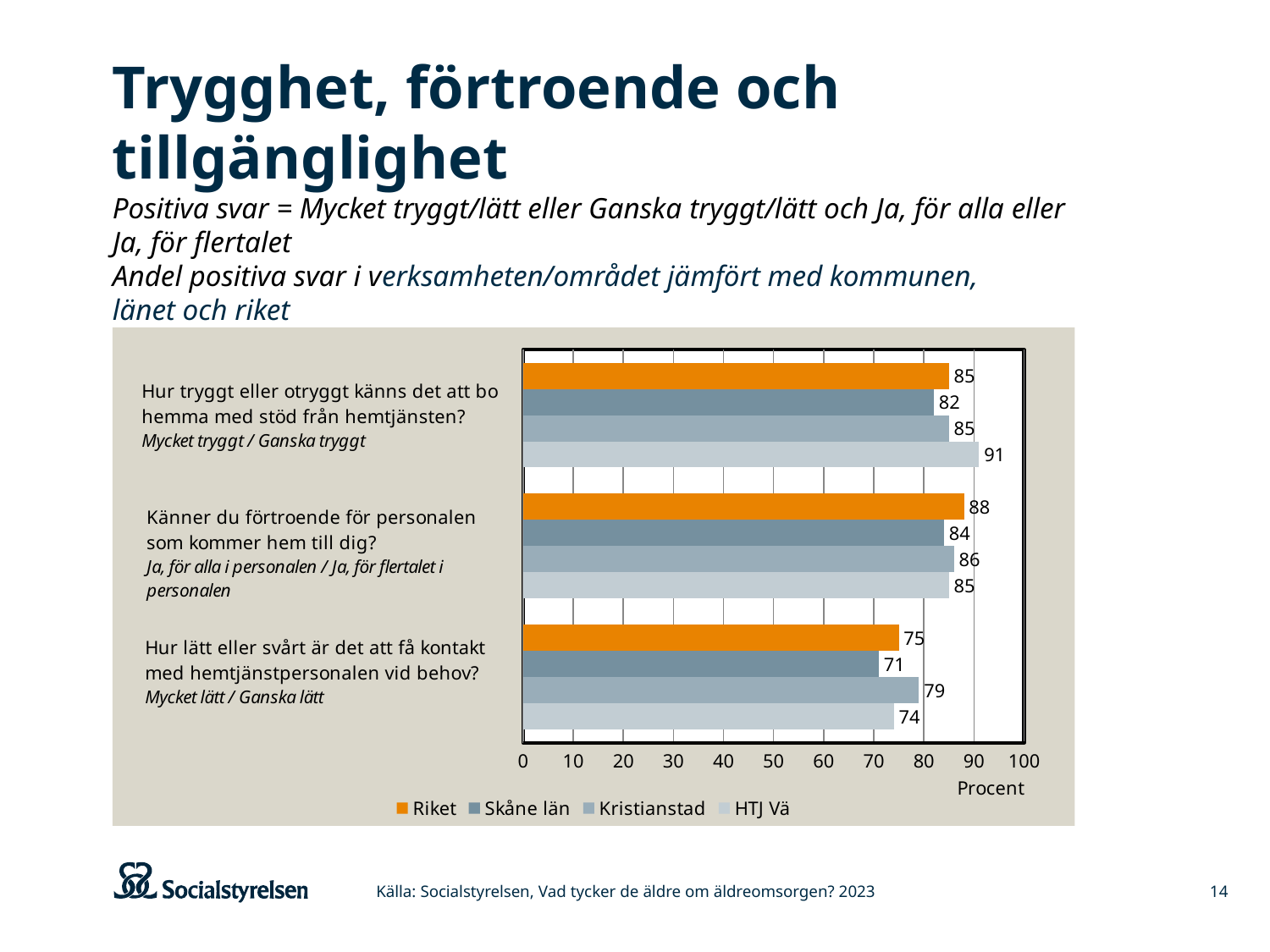
Which series has the lowest value on the question "Hur lätt eller svårt är det att få kontakt med hemtjänstpersonalen vid behov?"? Skåne län What is the value for Skåne län on the question "Hur lätt eller svårt är det att få kontakt med hemtjänstpersonalen vid behov?"? 71 Is the value for Riket on the question "Hur lätt eller svårt är det att få kontakt med hemtjänstpersonalen vid behov?" greater or less than 80? less What is the value for HTJ Vä on the question "Hur tryggt eller otryggt känns det att bo hemma med stöd från hemtjänsten?"? 91 On the question "Känner du förtroende för personalen som kommer hem till dig?", which is larger: the value for Kristianstad or the value for Skåne län? Kristianstad What is the difference between the Kristianstad value and the HTJ Vä value on the question "Hur lätt eller svårt är det att få kontakt med hemtjänstpersonalen vid behov?"? 5 How many question categories are shown on the chart? 3 What is the difference between the HTJ Vä value and the Skåne län value on the question "Hur tryggt eller otryggt känns det att bo hemma med stöd från hemtjänsten?"? 9 Which series has the highest value on the question "Hur tryggt eller otryggt känns det att bo hemma med stöd från hemtjänsten?"? HTJ Vä How many series does the legend list? 4 What kind of chart is shown on the slide? Bar chart What is the value for Riket on the question "Känner du förtroende för personalen som kommer hem till dig?"? 88